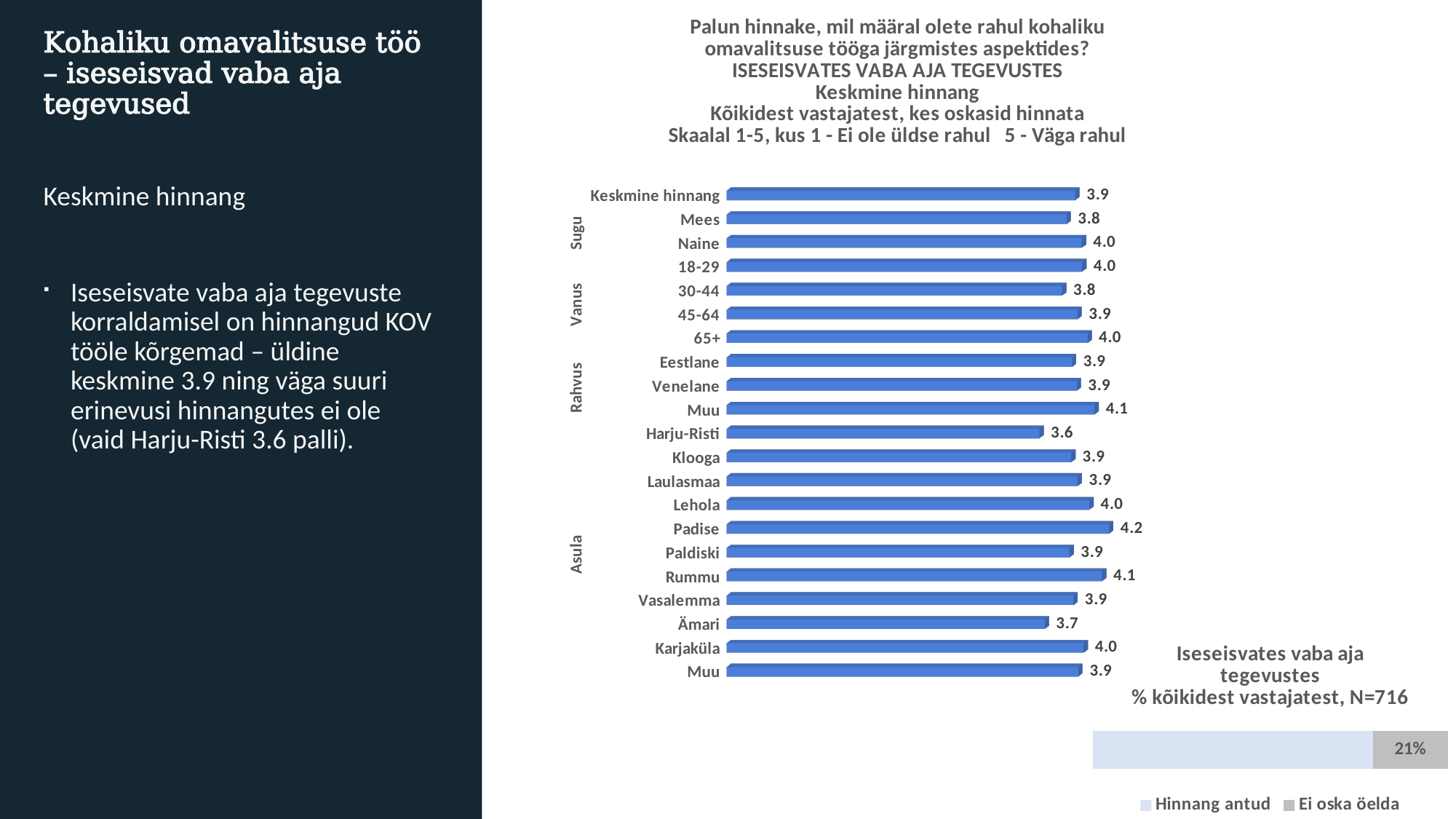
How many bars are plotted in the main bar chart? 21 What type of chart is the main chart on the slide? Bar chart In the main bar chart, what is the average rating (Keskmine hinnang) for Mees? 3.8 In the main bar chart, which category has the lowest average rating? Harju-Risti In the main bar chart, what is the value for Harju-Risti? 3.6 In the main bar chart, which has a higher value, Rummu or Ämari? Rummu In the main bar chart, which category has the highest average rating? Padise In the main bar chart, what is the difference between the values for Padise and Harju-Risti? 0.6 In the main bar chart, what is the value for the 65+ age group? 4.0 In the main bar chart, what is the value for Ämari? 3.7 In the main bar chart, what is the difference between the values for Naine and Mees? 0.2 In the small chart at the bottom right (% kõikidest vastajatest, N=716), what is the value for Ei oska öelda? 21%